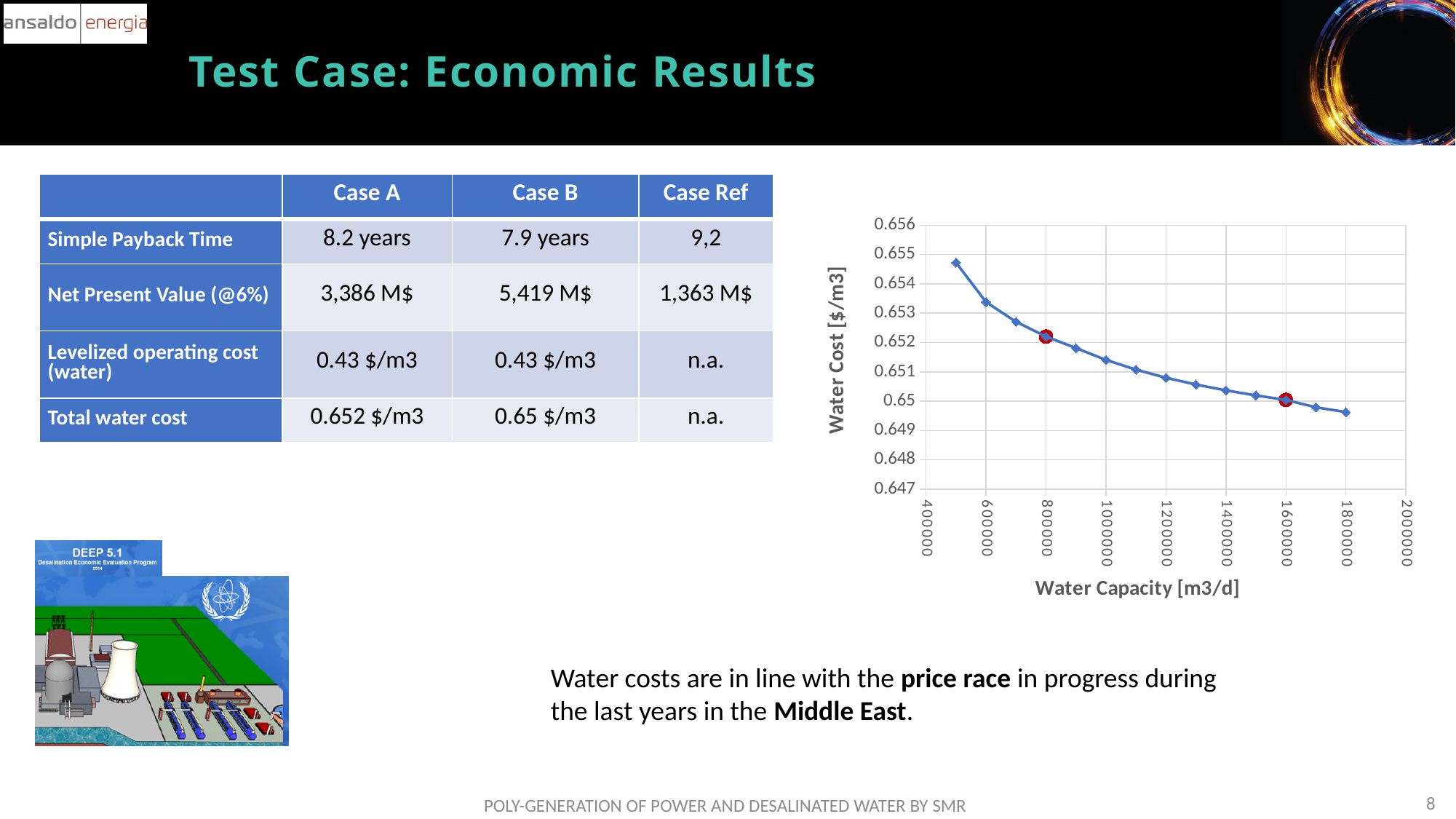
Does the water cost rise or fall as water capacity increases along the x axis? fall Is the water cost at a capacity of 500000 m3/d greater or less than 0.654? greater Which has the higher water cost: a capacity of 600000 m3/d or 1400000 m3/d? 600000 m3/d What kind of chart is shown on the slide? line chart Is the water cost at a capacity of 1800000 m3/d greater or less than 0.65? less What is the label of the x axis of the chart? Water Capacity [m3/d] Is the water cost at a capacity of 1400000 m3/d greater or less than 0.651? less At which water capacity is the water cost lowest? 1800000 What is the label of the y axis of the chart? Water Cost [$/m3] At which water capacity is the water cost highest? 500000